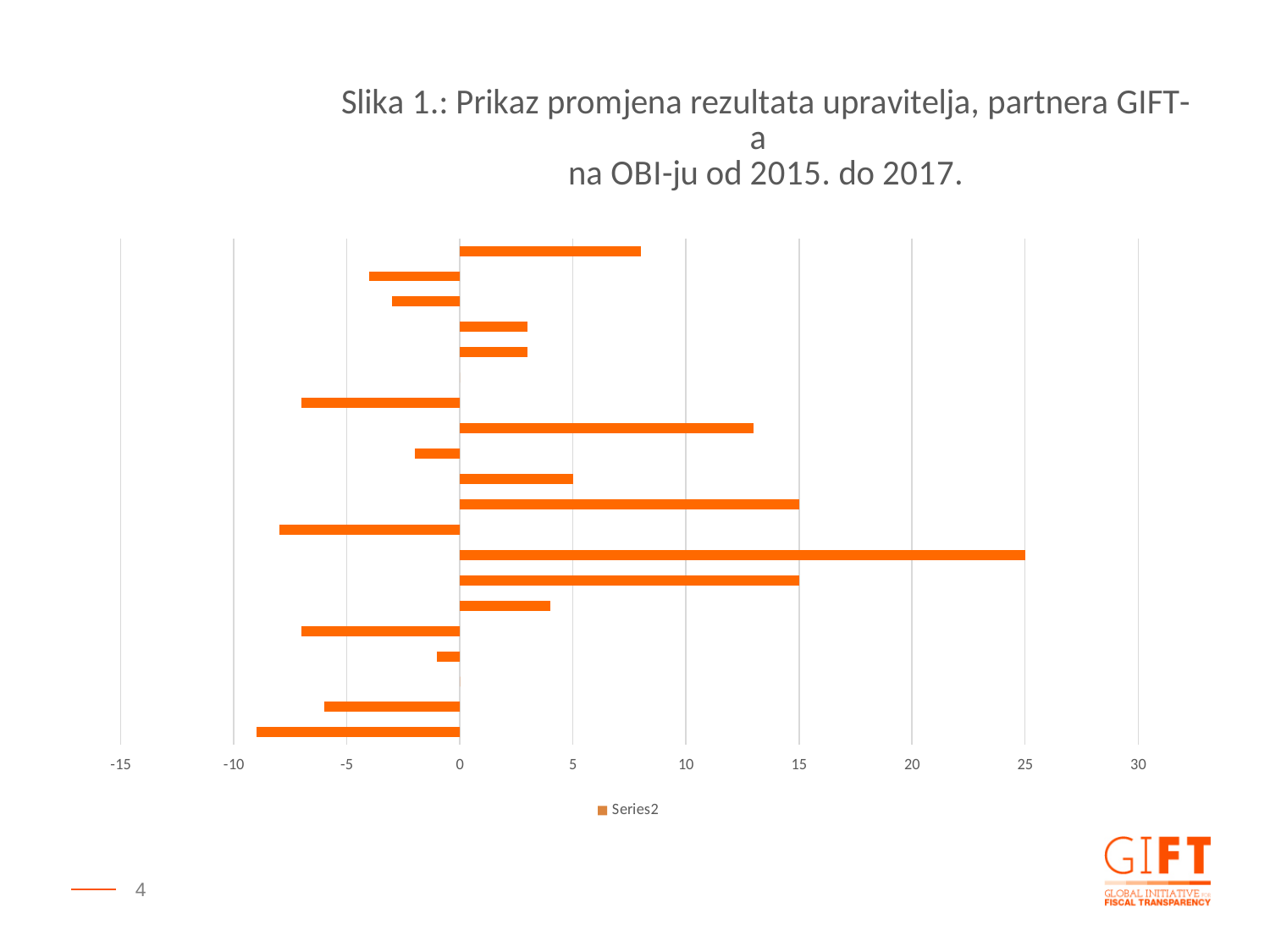
What is the name of the series shown in the legend? Series2 Is the value of the longest bar greater or less than 20? greater Is the value of the topmost bar greater or less than 5? greater What kind of chart is shown on the slide? bar chart What is the lowest tick value shown on the horizontal axis? -15 Is the value of the bottom bar greater or less than -5? less How many series does the legend list? 1 What is the value of the longest bar in the chart? 25 What is the highest tick value shown on the horizontal axis? 30